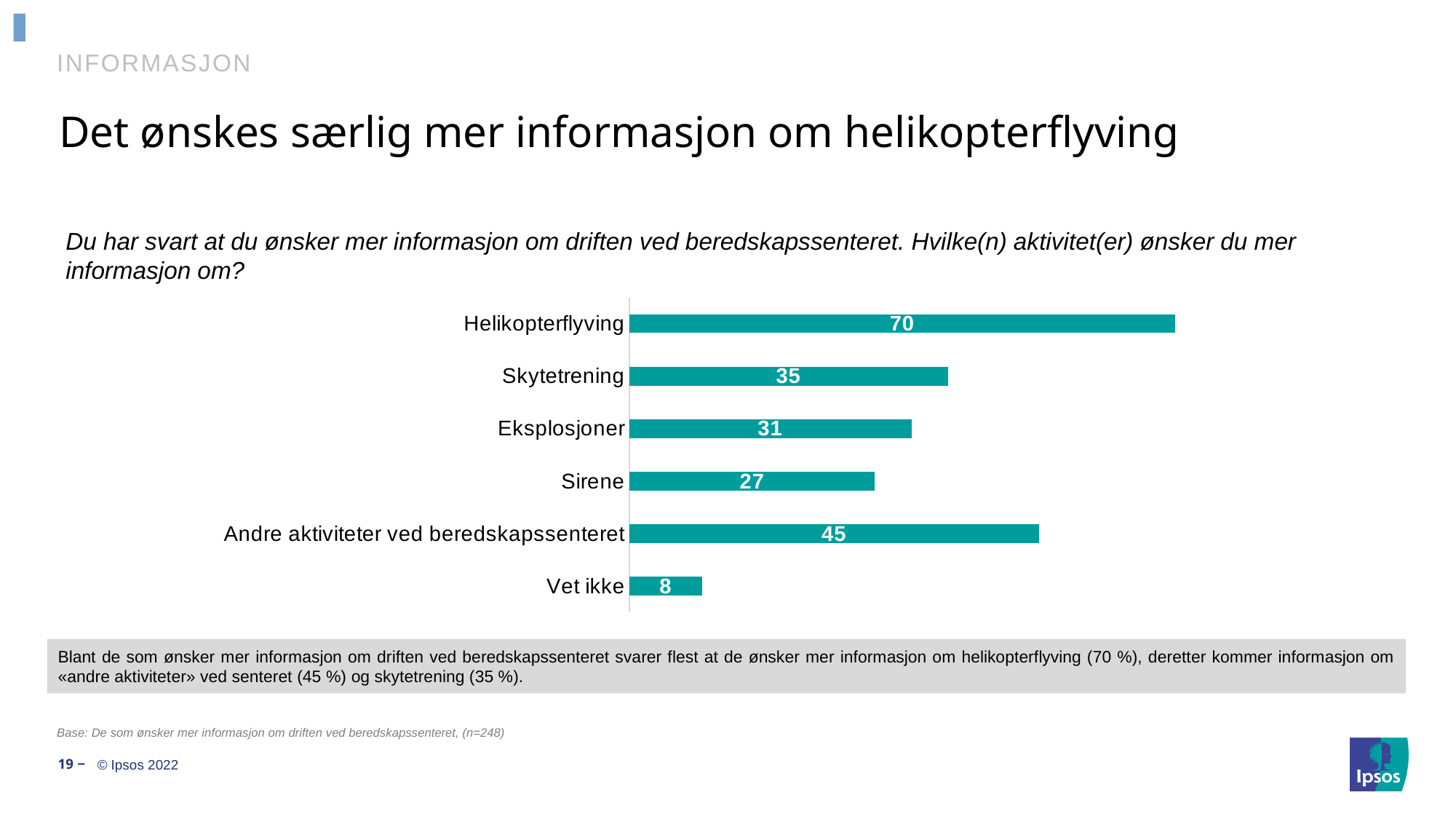
How many categories are shown in the chart? 6 What is the value for Eksplosjoner? 31 What is the value for Skytetrening? 35 Which category has the lowest value? Vet ikke What is the value for Helikopterflyving? 70 What is the difference between the values for Eksplosjoner and Vet ikke? 23 What is the value for Sirene? 27 Which category has the highest value? Helikopterflyving Which is larger, the value for Skytetrening or the value for Sirene? Skytetrening What kind of chart is shown on the slide? Bar chart What is the value for Andre aktiviteter ved beredskapssenteret? 45 What is the difference between the values for Helikopterflyving and Andre aktiviteter ved beredskapssenteret? 25